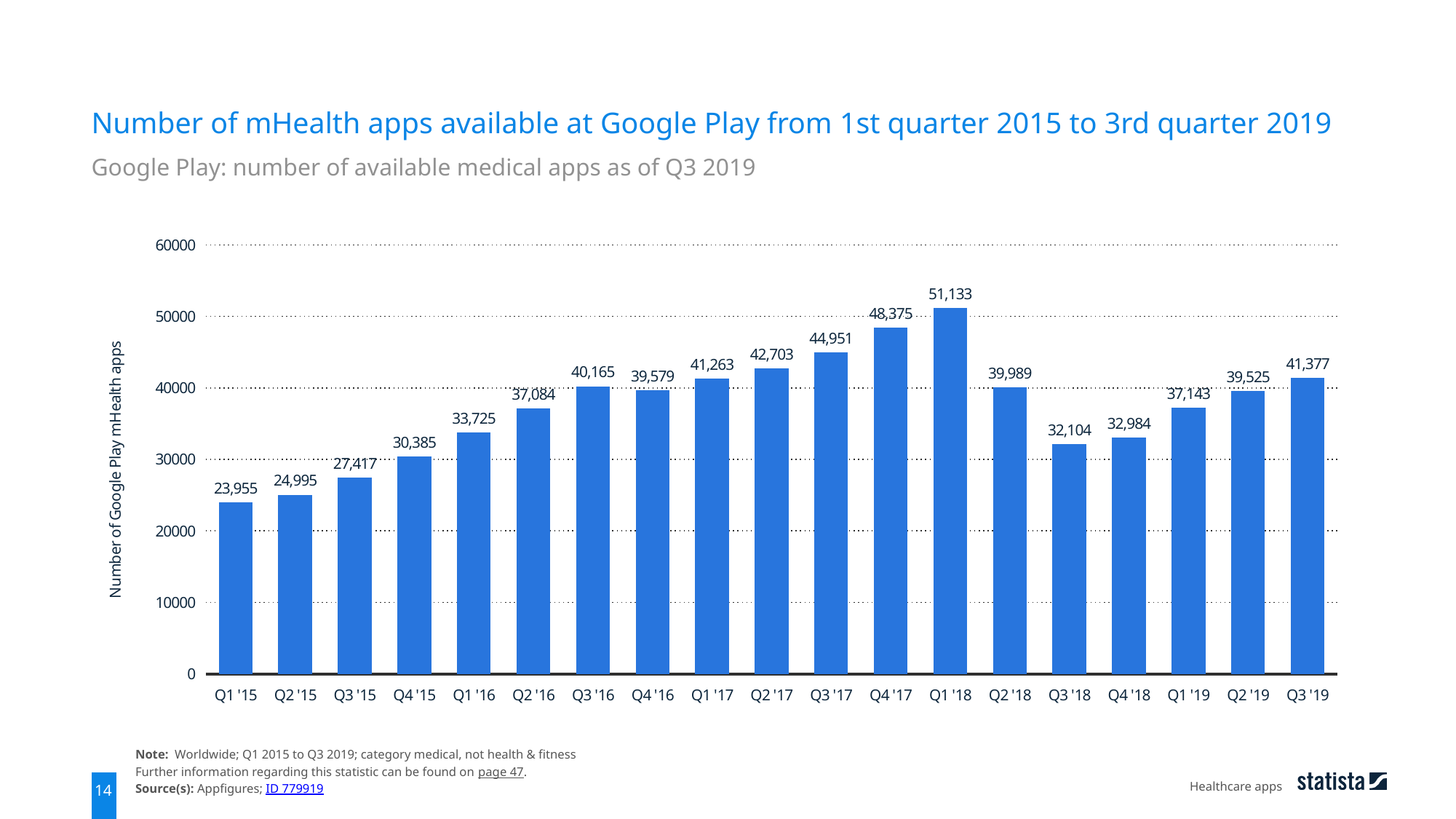
Is the value for Q3 '18 greater or less than 30000? greater What kind of chart is shown on the slide? Bar chart Which quarter has the highest number of Google Play mHealth apps? Q1 '18 What is the number of Google Play mHealth apps in Q3 '19? 41,377 What is the number of Google Play mHealth apps in Q1 '15? 23,955 How many quarters are shown on the x axis? 19 What is the label of the y axis? Number of Google Play mHealth apps Which quarter has the lowest number of Google Play mHealth apps? Q1 '15 Do the values rise or fall from Q1 '15 to Q1 '18? Rise What is the difference between the number of mHealth apps in Q1 '18 and Q2 '18? 11,144 Which quarter has more mHealth apps, Q3 '16 or Q4 '16? Q3 '16 What is the number of Google Play mHealth apps in Q1 '18? 51,133